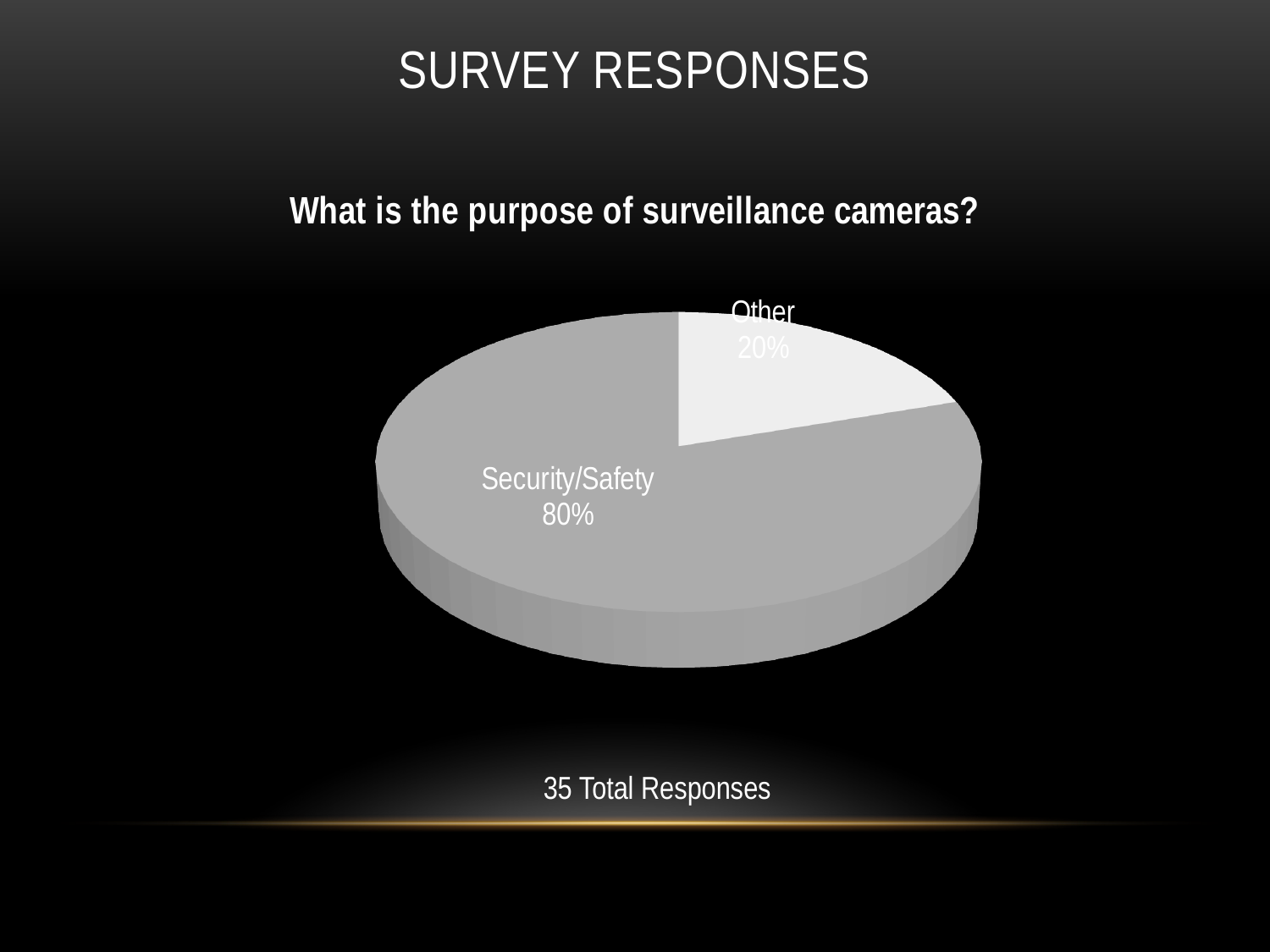
How many total responses does the slide say the survey received? 35 What is the difference in percentage points between the Security/Safety slice and the Other slice? 60 percentage points What type of chart is shown on the slide? Pie chart Which slice of the pie is the smallest? Other What is the title of the chart? What is the purpose of surveillance cameras? What share of the pie does Security/Safety represent? 80% Which is larger, the Security/Safety slice or the Other slice? Security/Safety What share of the pie does Other represent? 20% How many slices does the pie chart have? 2 Which slice of the pie is the largest? Security/Safety